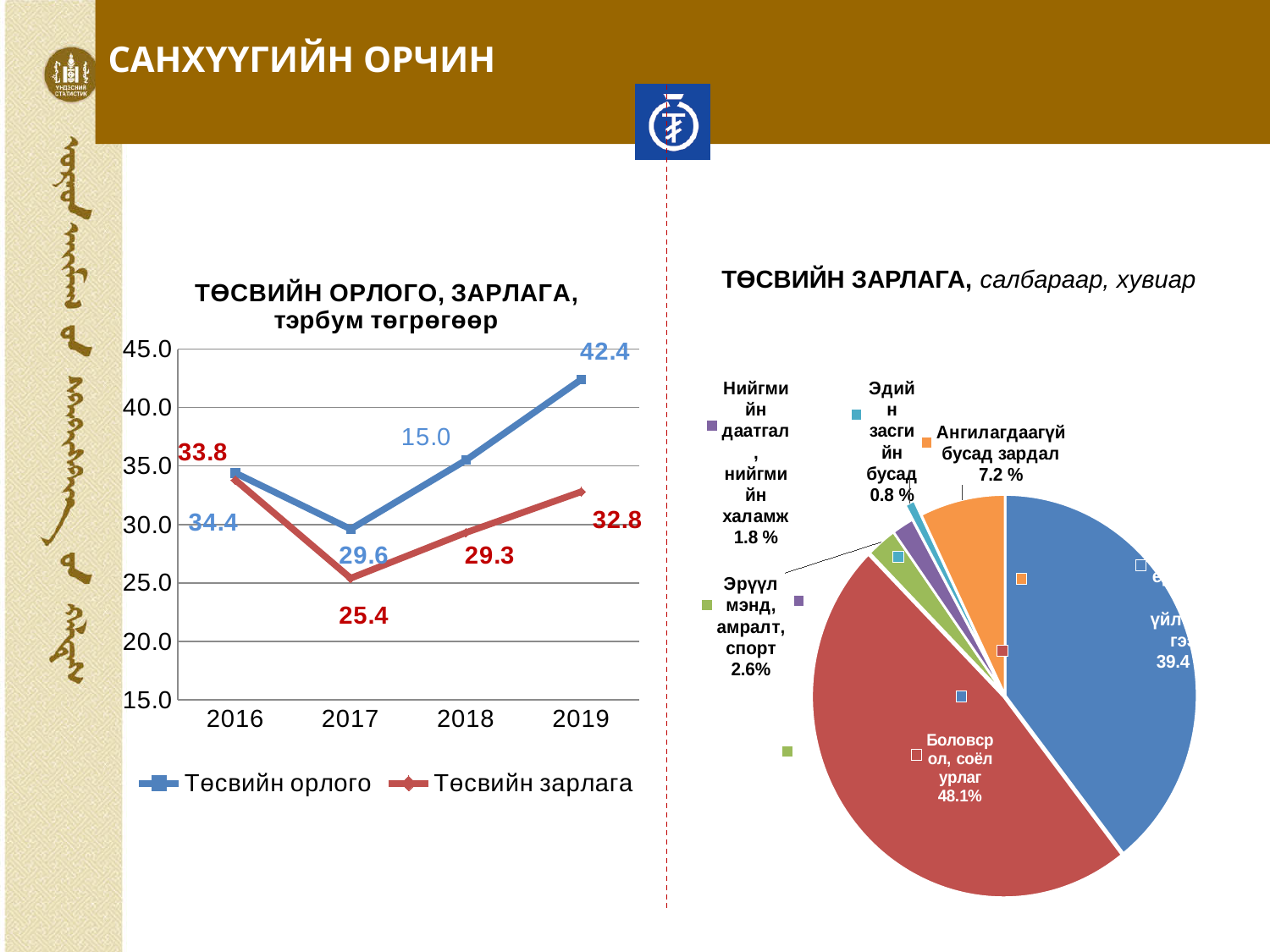
In the left chart 'ТӨСВИЙН ОРЛОГО, ЗАРЛАГА', what is the difference between Төсвийн орлого and Төсвийн зарлага in 2019? 9.6 How many years are shown on the x axis of the left chart 'ТӨСВИЙН ОРЛОГО, ЗАРЛАГА'? 4 In the left chart 'ТӨСВИЙН ОРЛОГО, ЗАРЛАГА', what is the value of Төсвийн орлого in 2019? 42.4 How many series does the legend of the left chart 'ТӨСВИЙН ОРЛОГО, ЗАРЛАГА' list? 2 In the right pie chart 'ТӨСВИЙН ЗАРЛАГА, салбараар, хувиар', which sector has the largest share? Боловсрол, соёл урлаг What kind of chart is the left chart titled 'ТӨСВИЙН ОРЛОГО, ЗАРЛАГА, тэрбум төгрөгөөр'? line chart In the right pie chart 'ТӨСВИЙН ЗАРЛАГА, салбараар, хувиар', what share does Ангилагдаагүй бусад зардал have? 7.2 % In the left chart 'ТӨСВИЙН ОРЛОГО, ЗАРЛАГА', in which year is Төсвийн зарлага lowest? 2017 In the left chart 'ТӨСВИЙН ОРЛОГО, ЗАРЛАГА', which series has the higher value in 2017, Төсвийн орлого or Төсвийн зарлага? Төсвийн орлого In the left chart 'ТӨСВИЙН ОРЛОГО, ЗАРЛАГА', in which year is Төсвийн орлого highest? 2019 In the left chart 'ТӨСВИЙН ОРЛОГО, ЗАРЛАГА', what is the value of Төсвийн зарлага in 2017? 25.4 What kind of chart is the right chart titled 'ТӨСВИЙН ЗАРЛАГА, салбараар, хувиар'? pie chart